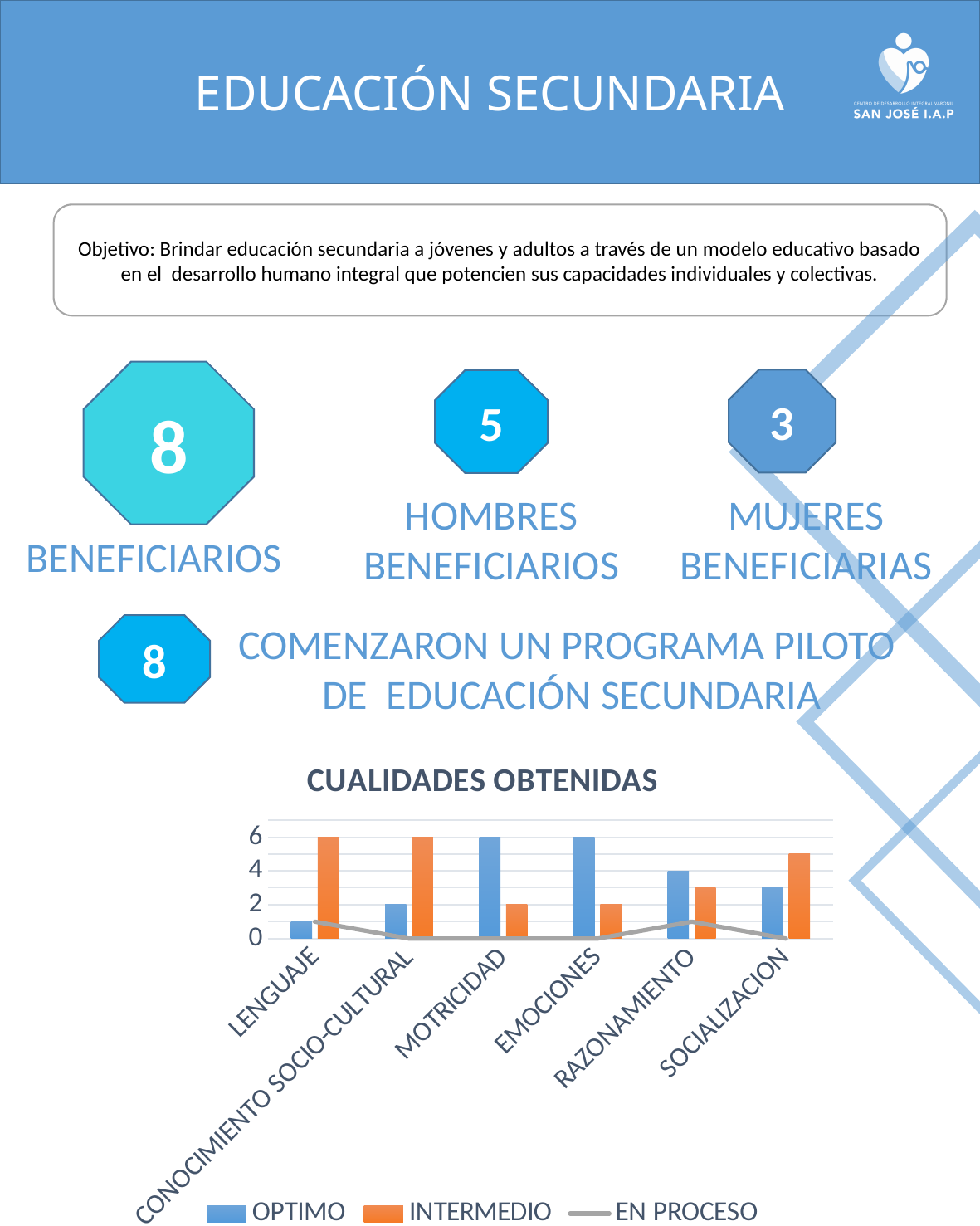
How many categories are shown on the x axis of the CUALIDADES OBTENIDAS chart? 6 What kind of chart is shown under the title CUALIDADES OBTENIDAS? Bar chart with a line series Which category has the lowest OPTIMO value? LENGUAJE How many series does the legend of the CUALIDADES OBTENIDAS chart list? 3 Is the INTERMEDIO value for SOCIALIZACION greater or less than 4? greater What is the OPTIMO value for MOTRICIDAD? 6 For MOTRICIDAD, what is the difference between the OPTIMO and INTERMEDIO values? 4 What is the OPTIMO value for RAZONAMIENTO? 4 For SOCIALIZACION, which is larger, the OPTIMO value or the INTERMEDIO value? INTERMEDIO What is the INTERMEDIO value for EMOCIONES? 2 Which series is drawn as a line in the CUALIDADES OBTENIDAS chart? EN PROCESO What is the INTERMEDIO value for LENGUAJE? 6